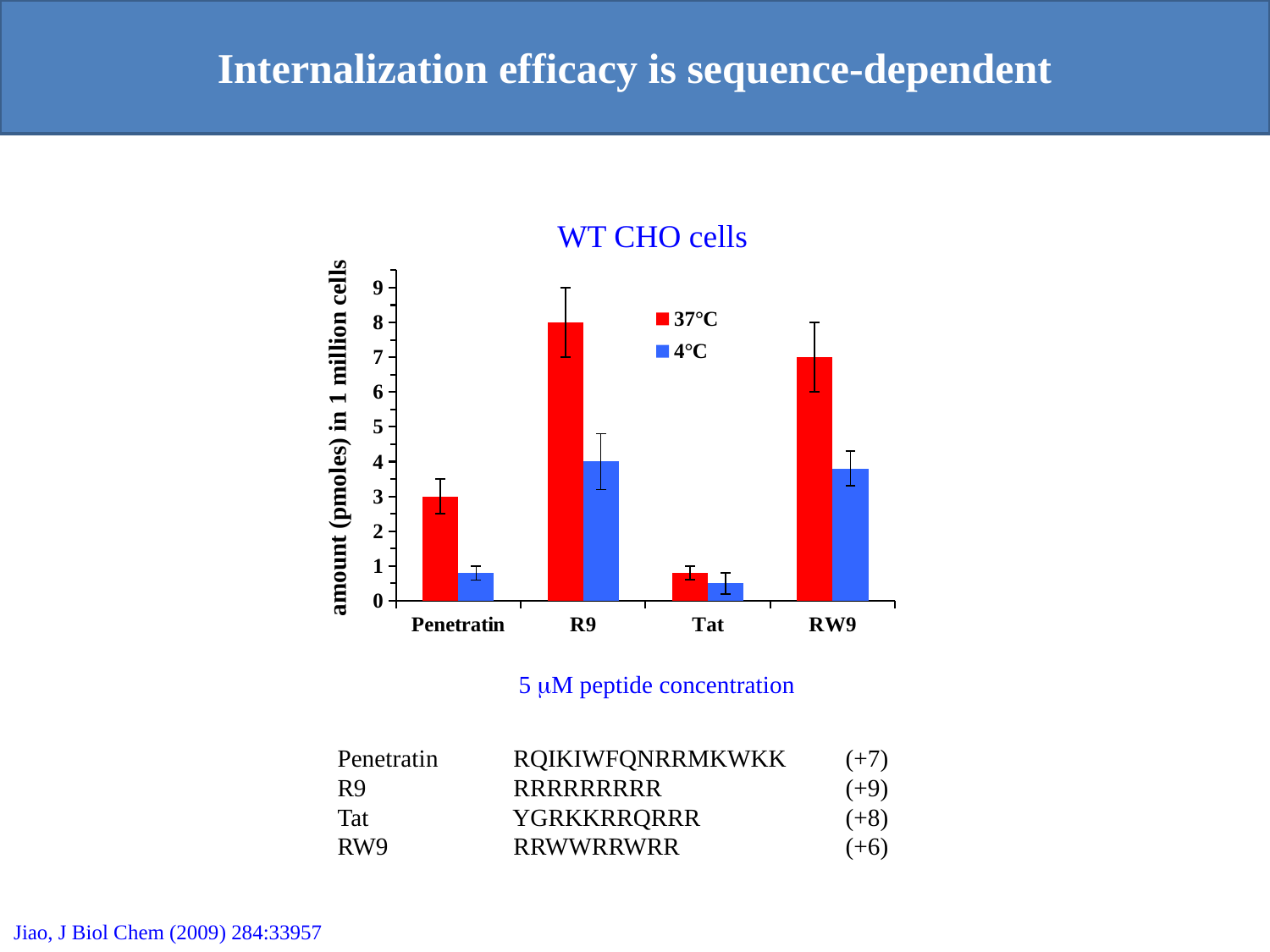
What is the y-axis label of the chart? amount (pmoles) in 1 million cells What is the title of the chart? WT CHO cells At 37°C, which has the larger value, R9 or Penetratin? R9 What is the value for R9 at 37°C? 8 Which peptide has the lowest value at 4°C? Tat Is the value for Tat at 37°C greater or less than 1? less How many series does the chart legend list? 2 How many peptide categories are shown on the x axis of the chart? 4 Is the value for RW9 at 4°C greater or less than 3? greater Which peptide has the highest value at 37°C? R9 What is the value for RW9 at 37°C? 7 What kind of chart is shown on the slide? bar chart